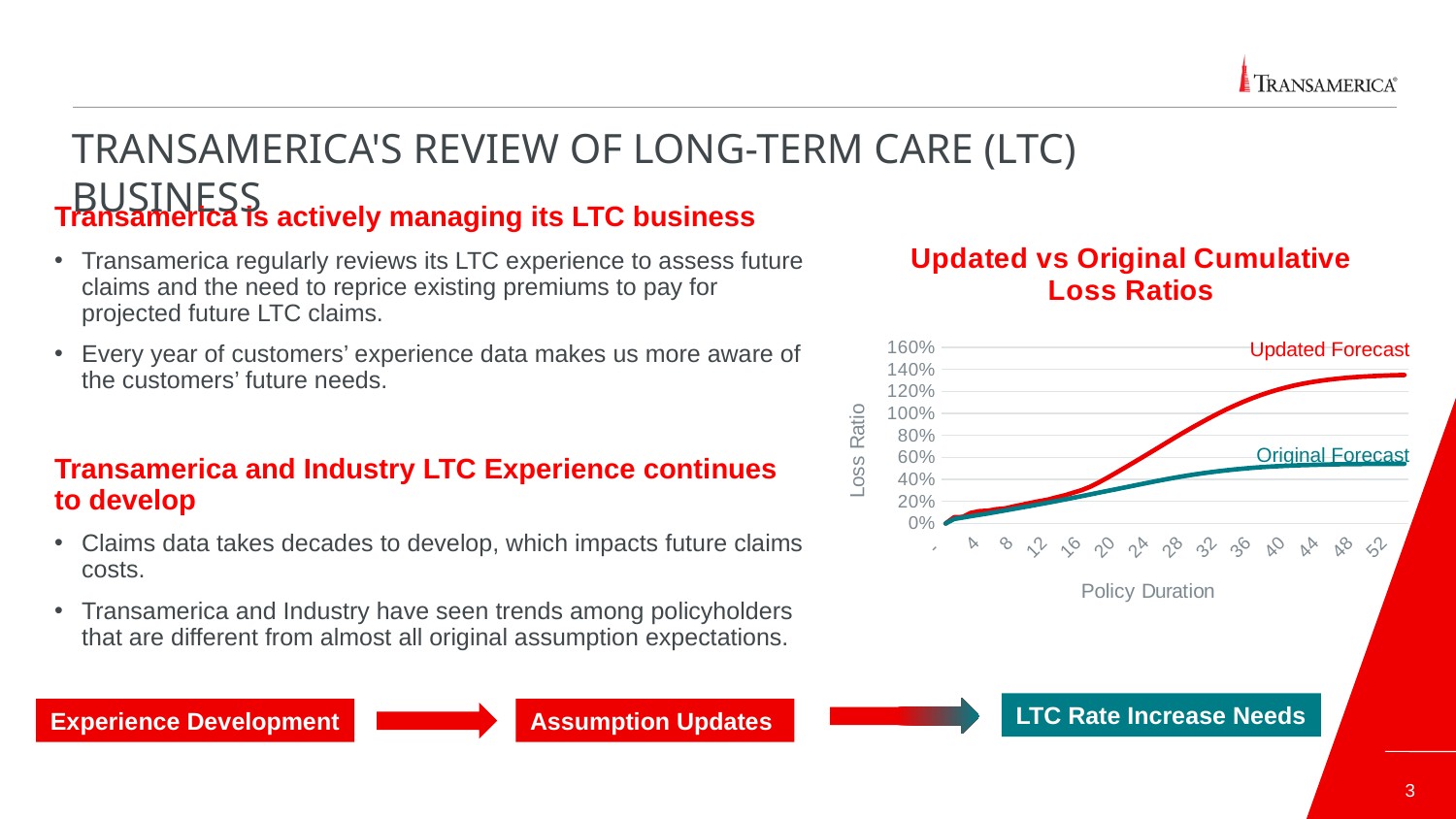
How many series are plotted in the chart? 2 Is the Original Forecast value at policy duration 52 greater or less than 80%? less Does the Original Forecast line rise or fall as policy duration increases? rise Which series reaches the highest loss ratio in the chart? Updated Forecast What is the label of the x axis of the chart? Policy Duration Does the Updated Forecast line rise or fall as policy duration increases? rise Is the Updated Forecast value at policy duration 20 greater or less than 100%? less Is the Updated Forecast value at policy duration 52 greater or less than 100%? greater At policy duration 52, which series has the higher loss ratio, Updated Forecast or Original Forecast? Updated Forecast What kind of chart is shown on the slide? line chart What is the title of the chart? Updated vs Original Cumulative Loss Ratios